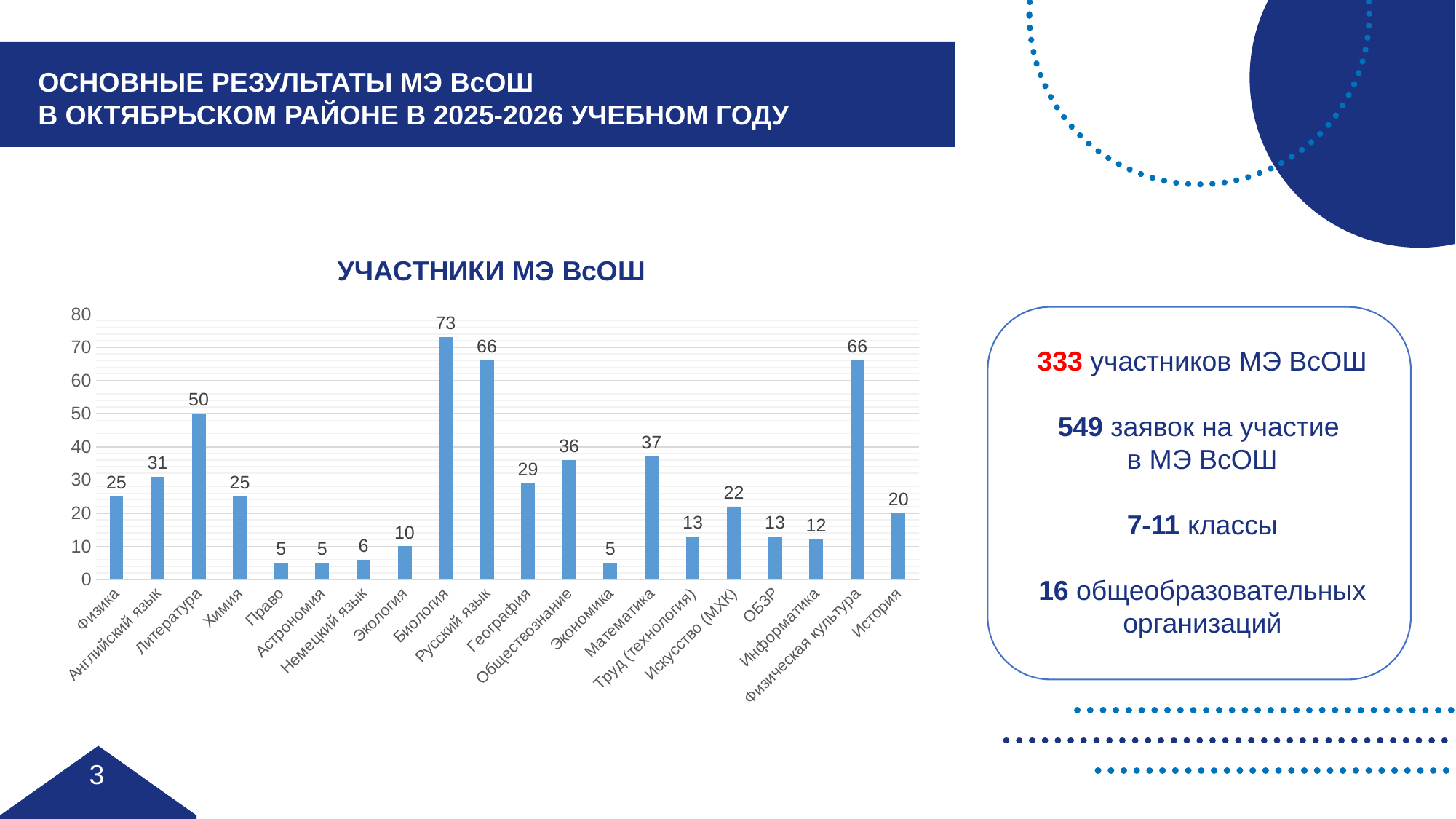
What is the title of the chart? УЧАСТНИКИ МЭ ВсОШ How many subjects (categories) are shown in the chart? 20 Which subject has the highest number of participants? Биология Is the value for Физическая культура greater or less than 60? greater What is the difference between the values for Биология and Русский язык? 7 What is the value for Литература? 50 How many participants are shown for Биология? 73 What is the value for Математика? 37 What is the value for Информатика? 12 What is the lowest value shown in the chart? 5 Which has a larger value, Обществознание or География? Обществознание What type of chart is shown on the slide? bar chart